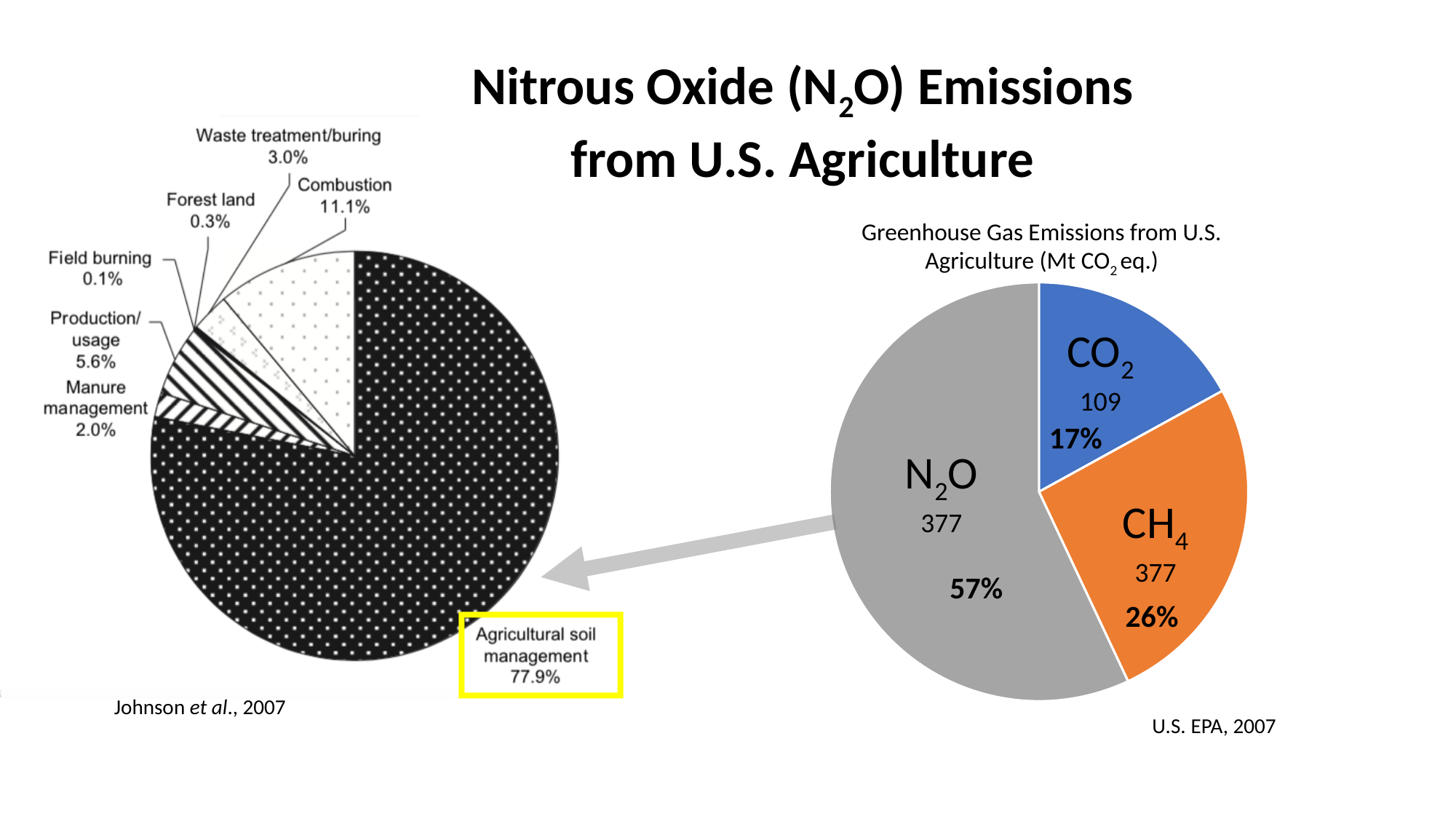
In the pie chart on the right (Greenhouse Gas Emissions from U.S. Agriculture), what share is labelled for N2O? 57% What kind of chart is used on the right side of the slide for Greenhouse Gas Emissions from U.S. Agriculture? Pie chart In the pie chart on the right (Greenhouse Gas Emissions from U.S. Agriculture), which gas has the smallest slice? CO2 In the pie chart on the right (Greenhouse Gas Emissions from U.S. Agriculture), what percentage is shown for CH4? 26% In the pie chart on the right (Greenhouse Gas Emissions from U.S. Agriculture), what is the difference in percentage points between the N2O share and the CH4 share? 31 In the pie chart on the left (N2O emission sources), what percentage is shown for Agricultural soil management? 77.9% In the pie chart on the right (Greenhouse Gas Emissions from U.S. Agriculture), what value in Mt CO2 eq. is shown for CO2? 109 In the pie chart on the left (N2O emission sources), which is larger, Production/usage or Manure management? Production/usage In the pie chart on the right (Greenhouse Gas Emissions from U.S. Agriculture), how many slices does the pie have? 3 In the pie chart on the right (Greenhouse Gas Emissions from U.S. Agriculture), which gas has the largest slice? N2O In the pie chart on the left (N2O emission sources), which source has the smallest share? Field burning In the pie chart on the left (N2O emission sources), what percentage is shown for Combustion? 11.1%